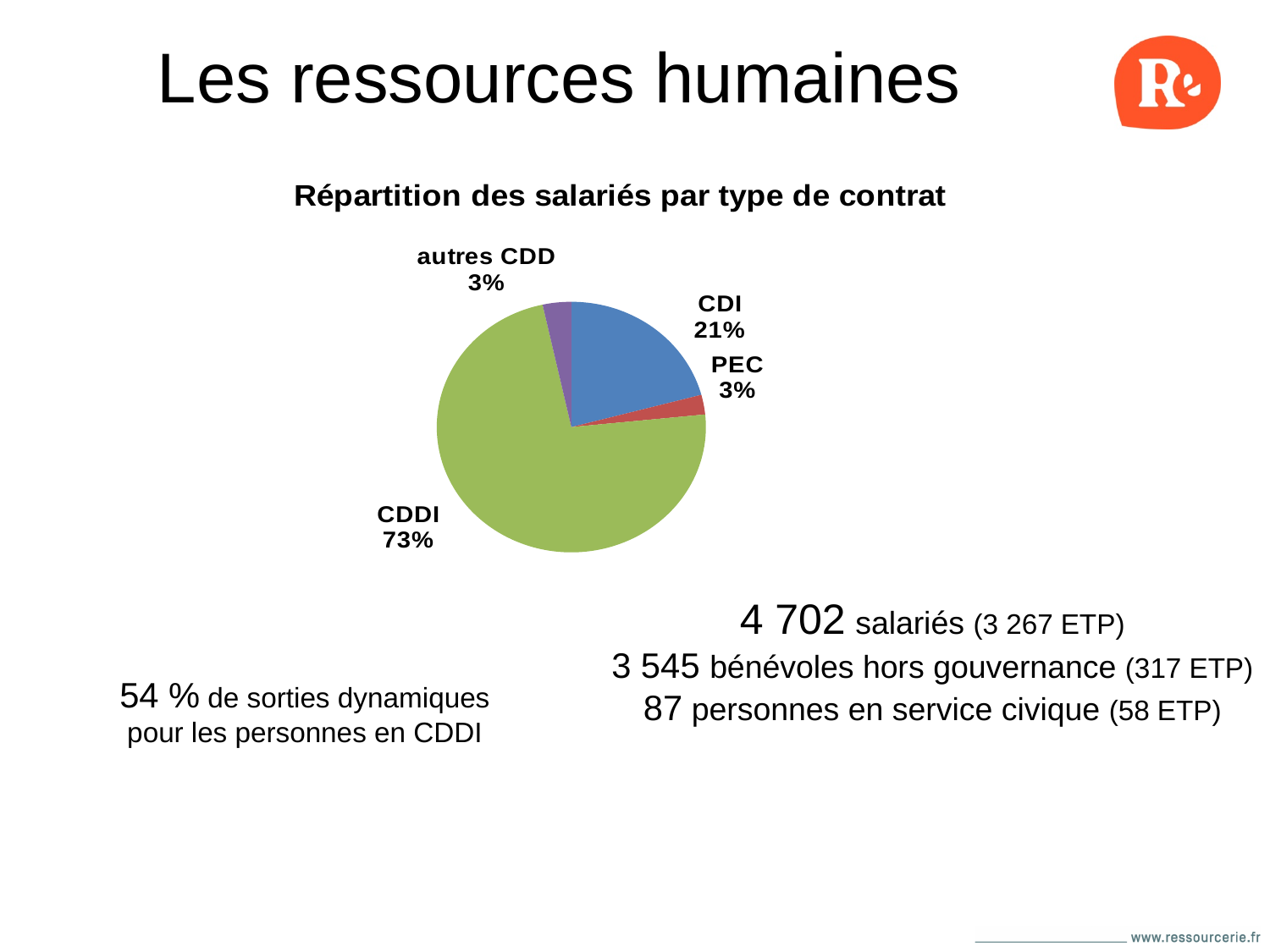
What share of the pie does CDI represent? 21% What share of the pie does PEC represent? 3% What is the combined share of CDI and CDDI? 94% Which is larger, the share for CDI or the share for PEC? CDI What is the title of the chart? Répartition des salariés par type de contrat How many slices does the pie chart have? 4 What share of the pie does autres CDD represent? 3% Which contract type has the largest share of the pie? CDDI What is the difference in percentage points between the CDDI share and the CDI share? 52 What colour is the CDDI slice? green What type of chart is shown on the slide? pie chart